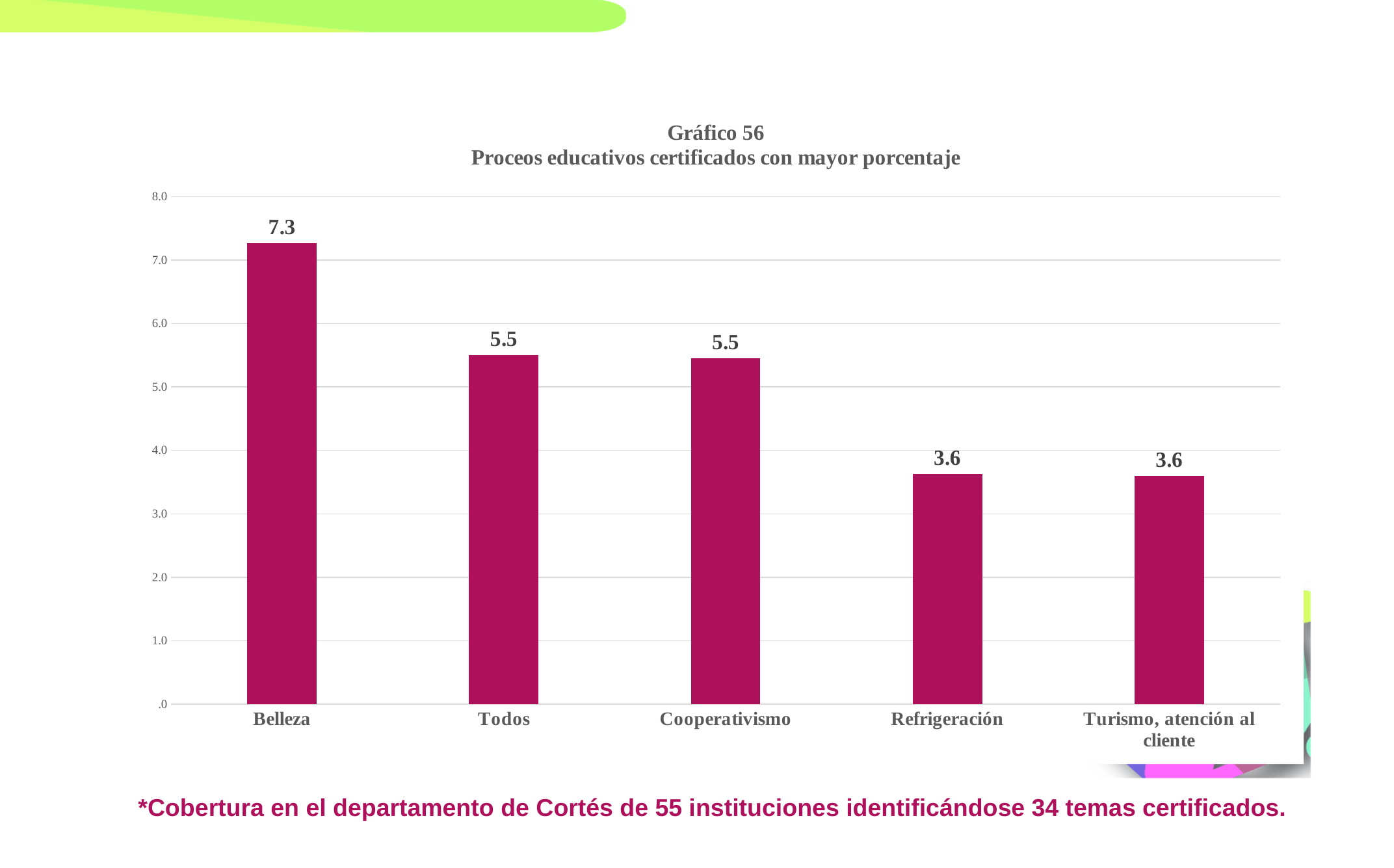
What is the difference between the values for Cooperativismo and Refrigeración? 1.9 What is the value for Refrigeración? 3.6 What is the value for Turismo, atención al cliente? 3.6 What kind of chart is shown on the slide? bar chart Do the values rise or fall from left to right along the x axis? fall Which category has the highest value? Belleza Is the value for Belleza greater or less than 7.0? greater What is the value for Belleza? 7.3 What is the difference between the values for Belleza and Todos? 1.8 What is the value for Cooperativismo? 5.5 How many categories are shown on the x axis? 5 Which is larger, the value for Belleza or the value for Todos? Belleza